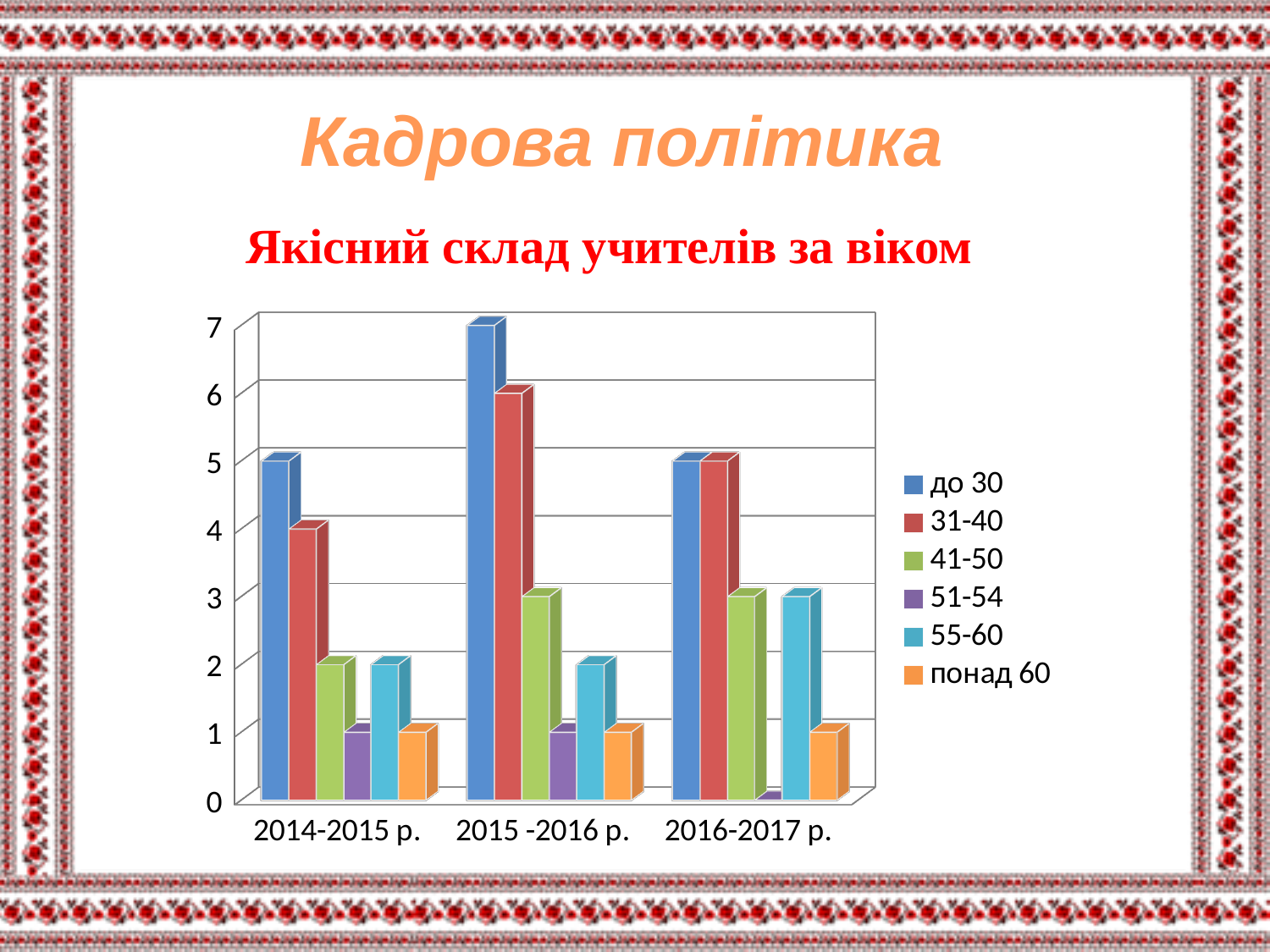
What is the value for the "41-50" series in 2016-2017 р.? 3 In which school year does the "до 30" series reach its highest value? 2015 -2016 р. What is the title of the chart? Якісний склад учителів за віком What is the value for the "31-40" series in 2014-2015 р.? 4 How many school-year categories are shown on the x axis? 3 Is the value for "31-40" in 2015 -2016 р. greater or less than 4? greater What kind of chart is shown on the slide? bar chart What is the value for the "до 30" series in 2015 -2016 р.? 7 Which is larger in 2014-2015 р.: the value for "до 30" or the value for "41-50"? до 30 What is the difference between the "до 30" and "31-40" values in 2015 -2016 р.? 1 Which series has the highest value in 2015 -2016 р.? до 30 How many series does the legend list? 6